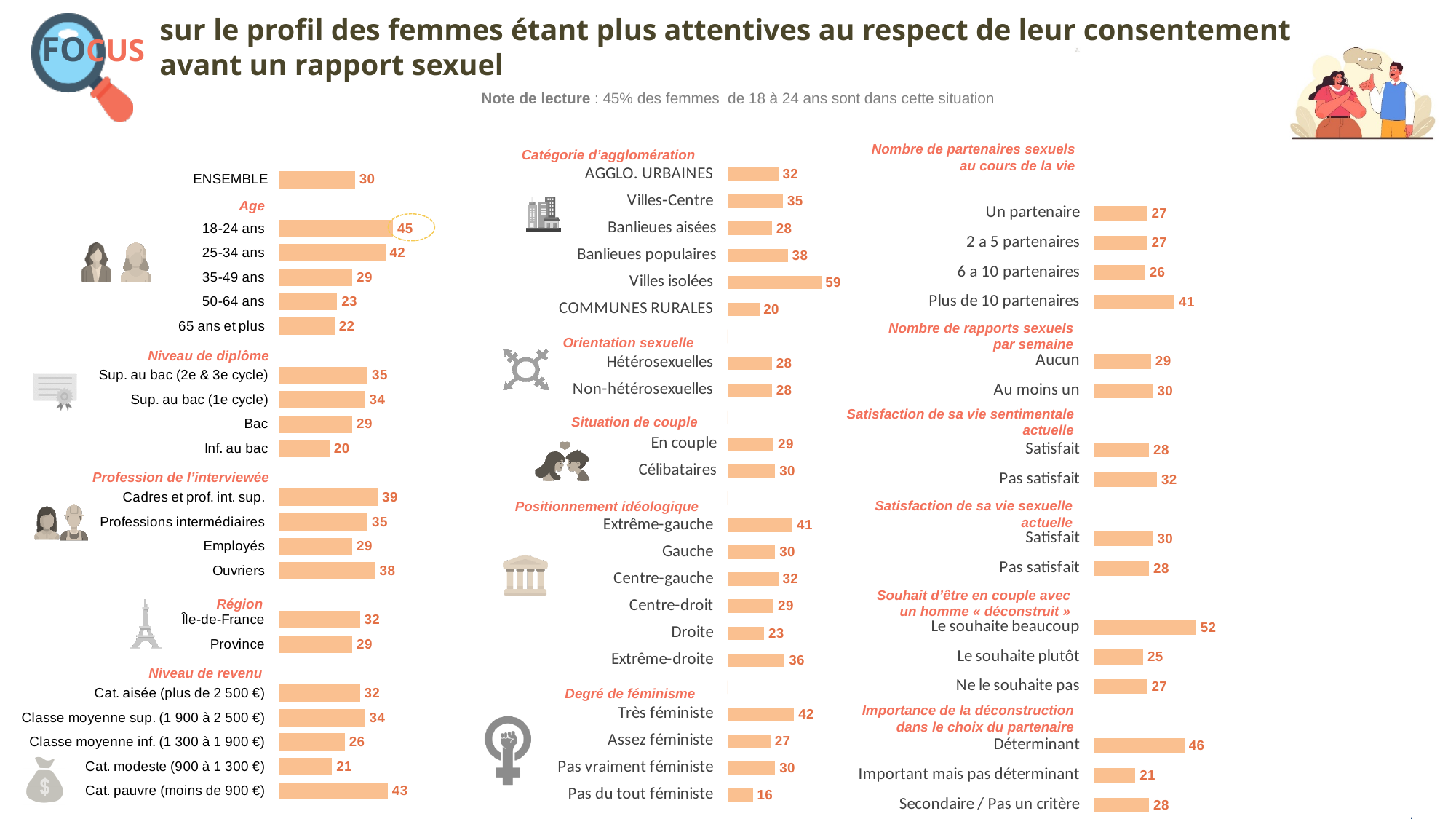
In the 'Importance de la déconstruction dans le choix du partenaire' chart, what is the value for 'Déterminant'? 46 What type of chart is used on this slide? Bar chart In the 'Age' chart, what is the value for '18-24 ans'? 45 What is the value for 'ENSEMBLE' on the slide? 30 In the 'Degré de féminisme' chart, which category has the lowest value? Pas du tout féministe How many categories are shown in the 'Nombre de partenaires sexuels au cours de la vie' chart? 4 In the 'Niveau de revenu' chart, what is the difference between 'Cat. pauvre (moins de 900 €)' and 'Cat. modeste (900 à 1 300 €)'? 22 In the 'Catégorie d'agglomération' chart, which category has the highest value? Villes isolées In the 'Positionnement idéologique' chart, which is larger: 'Extrême-gauche' or 'Extrême-droite'? Extrême-gauche In the 'Age' chart, do the values rise or fall as age increases from '18-24 ans' to '65 ans et plus'? Fall In the 'Catégorie d'agglomération' chart, what is the value for 'COMMUNES RURALES'? 20 In the 'Souhait d'être en couple avec un homme « déconstruit »' chart, what is the value for 'Le souhaite beaucoup'? 52